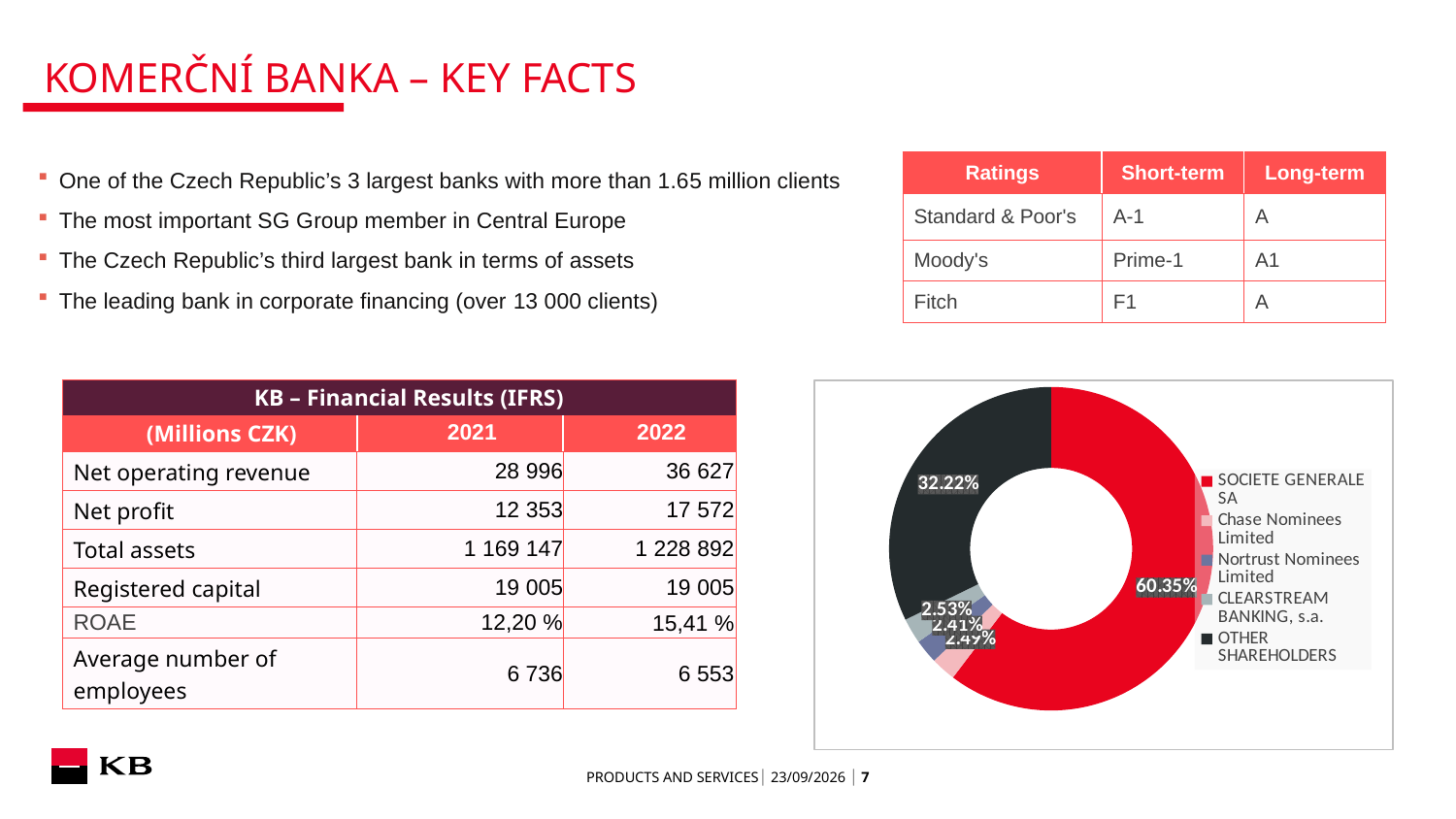
Which colour represents SOCIETE GENERALE SA in the chart? Red What share of the chart do OTHER SHAREHOLDERS hold? 32.22% What is the combined share of SOCIETE GENERALE SA and OTHER SHAREHOLDERS in the chart? 92.57% Which shareholder category has the largest slice in the chart? SOCIETE GENERALE SA Which is larger in the chart: the slice for SOCIETE GENERALE SA or the slice for OTHER SHAREHOLDERS? SOCIETE GENERALE SA What kind of chart is shown on the right side of the slide? Doughnut (pie) chart Which legend entry is shown in the dark (black) colour in the chart? OTHER SHAREHOLDERS What is the difference in percentage points between the SOCIETE GENERALE SA slice and the OTHER SHAREHOLDERS slice? 28.13% How many shareholder categories does the chart legend list? 5 What share of the chart does SOCIETE GENERALE SA hold? 60.35% How many slices does the doughnut chart have? 5